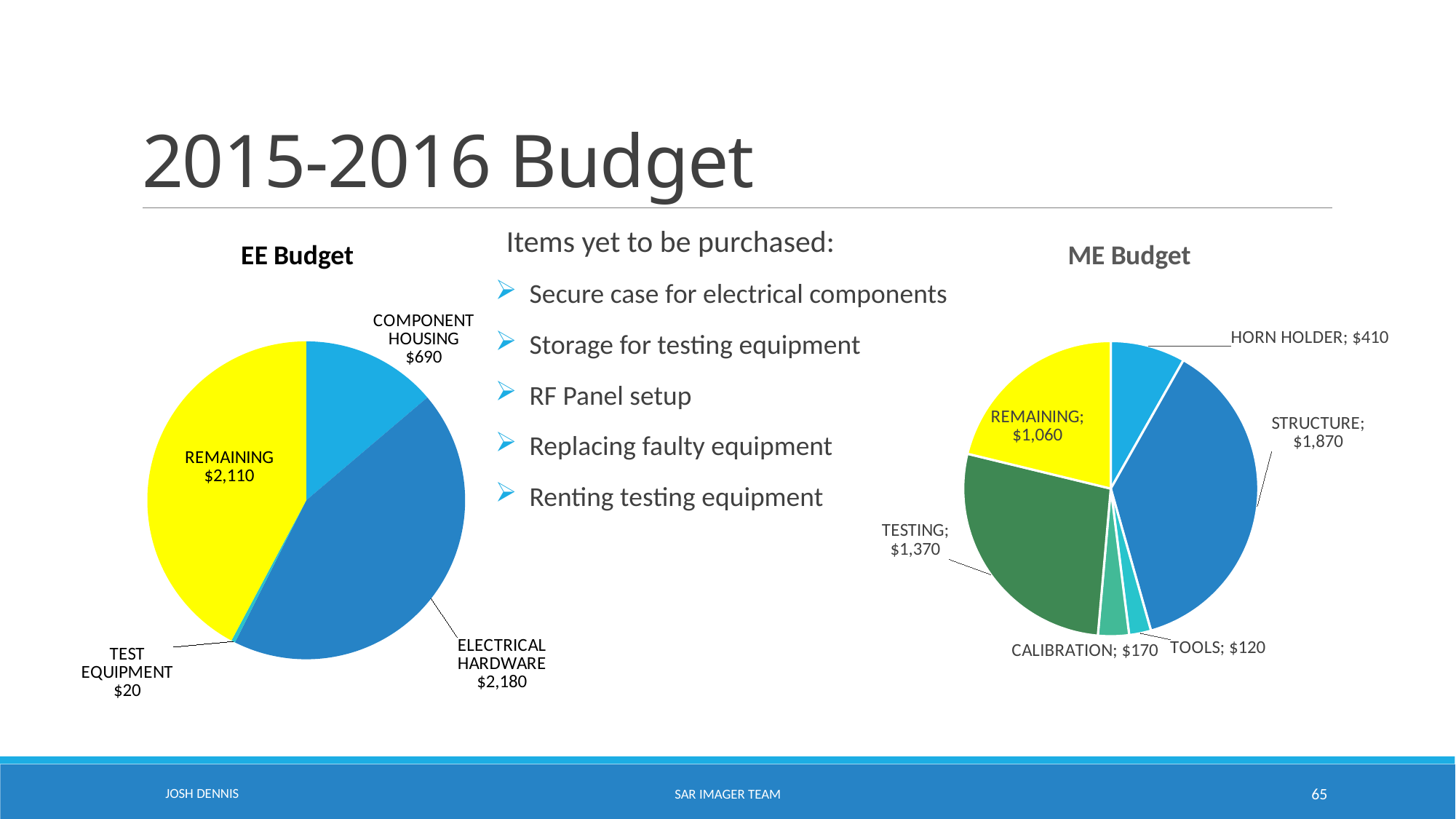
In the ME Budget chart, what is the difference between STRUCTURE and TESTING? $500 In the ME Budget chart, which category has the largest value? STRUCTURE In the EE Budget chart, what is the difference between REMAINING and COMPONENT HOUSING? $1,420 In the EE Budget chart, what is the value for ELECTRICAL HARDWARE? $2,180 In the EE Budget chart, which category has the smallest value? TEST EQUIPMENT In the ME Budget chart, which category has the smallest value? TOOLS In the ME Budget chart, what is the value for TESTING? $1,370 How many slices does the ME Budget chart have? 6 In the ME Budget chart, which is larger, CALIBRATION or TOOLS? CALIBRATION In the ME Budget chart, what is the value for HORN HOLDER? $410 In the EE Budget chart, what is the value for TEST EQUIPMENT? $20 What kind of chart is the EE Budget chart? Pie chart